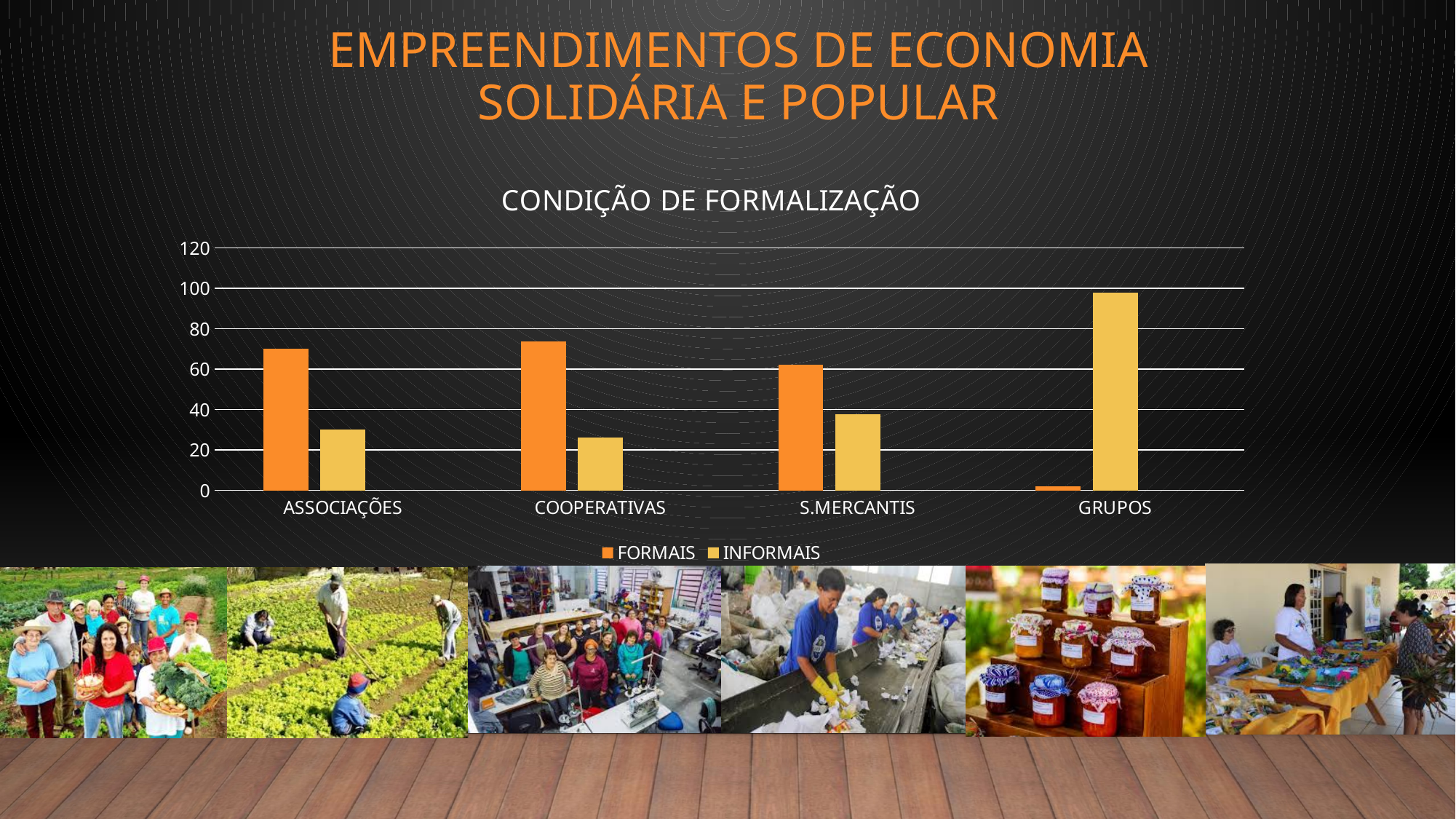
How many series does the legend list? 2 Which category has the lowest INFORMAIS value? COOPERATIVAS Is the FORMAIS value for S.MERCANTIS greater or less than 80? less Which category has the lowest FORMAIS value? GRUPOS What is the title of the chart? CONDIÇÃO DE FORMALIZAÇÃO What kind of chart is shown on the slide? bar chart Which category has the highest FORMAIS value? COOPERATIVAS For ASSOCIAÇÕES, which is larger, FORMAIS or INFORMAIS? FORMAIS Is the INFORMAIS value for GRUPOS greater or less than 80? greater Which category has the highest INFORMAIS value? GRUPOS For GRUPOS, which is larger, FORMAIS or INFORMAIS? INFORMAIS How many categories are shown on the x axis? 4